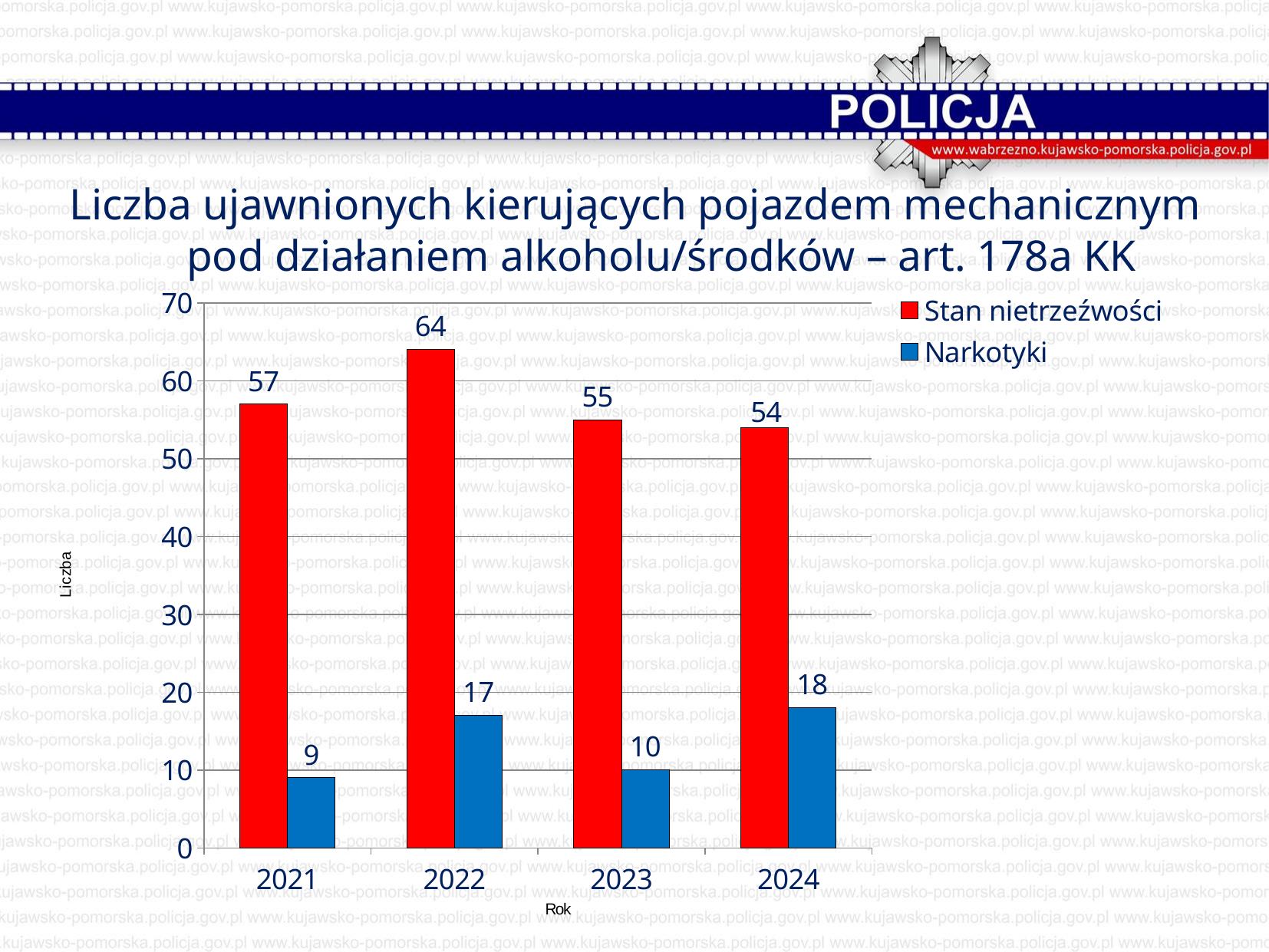
Which year has the lowest value for Narkotyki? 2021 Which is larger: the Narkotyki value for 2022 or for 2024? 2024 What kind of chart is shown on the slide? bar chart What is the value for Stan nietrzeźwości in 2022? 64 What colour are the bars for Narkotyki? blue How many years are shown on the x axis? 4 Does the Stan nietrzeźwości series rise or fall from 2022 to 2024? fall Is the value for Stan nietrzeźwości in 2024 greater or less than 50? greater What is the difference between the Stan nietrzeźwości values for 2022 and 2021? 7 How many series does the legend list? 2 Which year has the highest value for Stan nietrzeźwości? 2022 What is the value for Narkotyki in 2023? 10